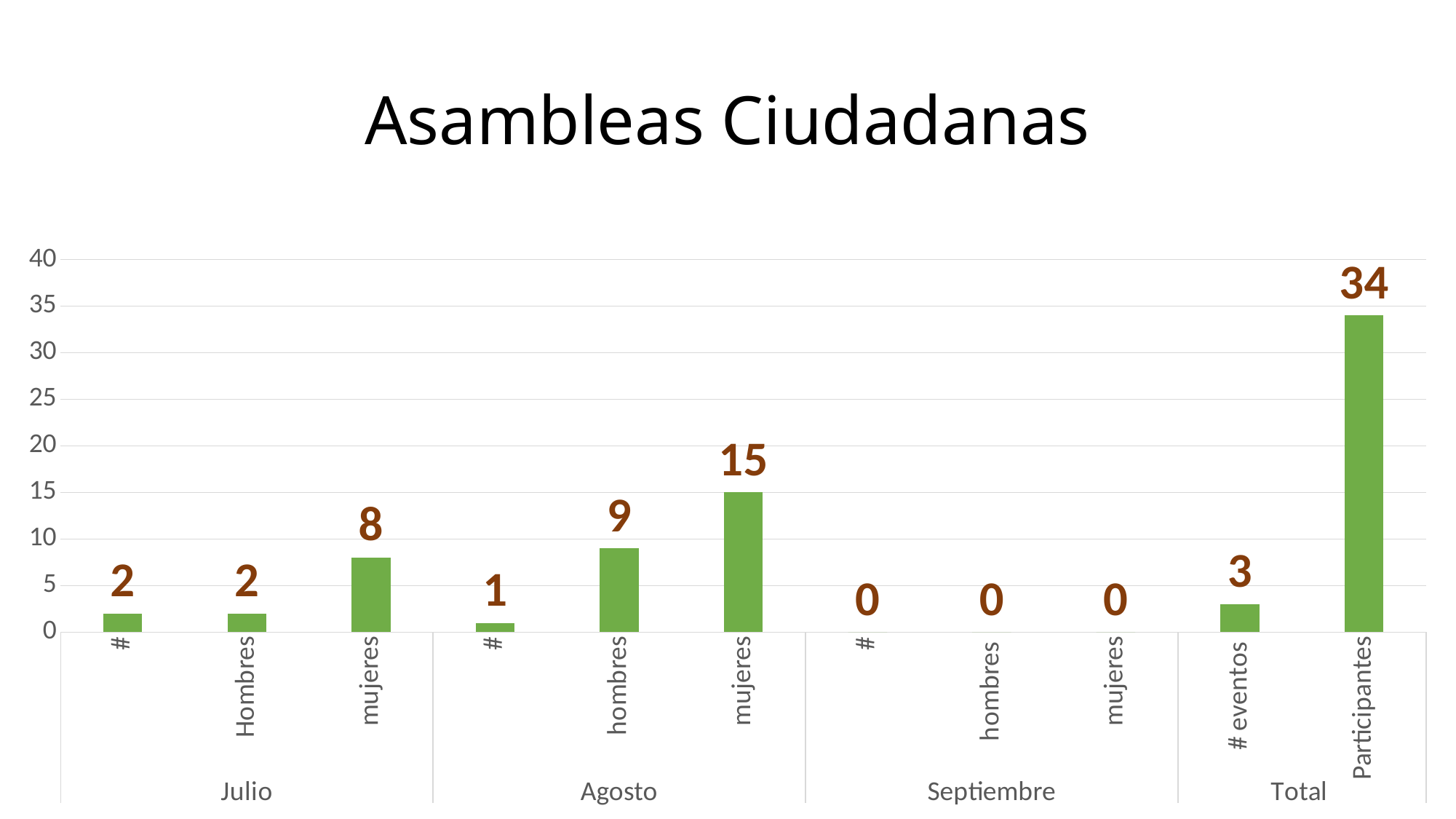
What is the value for Hombres in Julio? 2 Which is larger, hombres in Agosto or mujeres in Julio? hombres in Agosto What is the value for Participantes under Total? 34 What is the difference between Participantes and # eventos under Total? 31 What is the difference between mujeres in Agosto and mujeres in Julio? 7 Which category has the highest value? Participantes (Total) What is the title of the chart? Asambleas Ciudadanas What is the value for hombres in Septiembre? 0 What kind of chart is shown? bar chart What is the value for # eventos under Total? 3 What is the value for mujeres in Agosto? 15 How many bars (categories) are plotted on the chart? 11